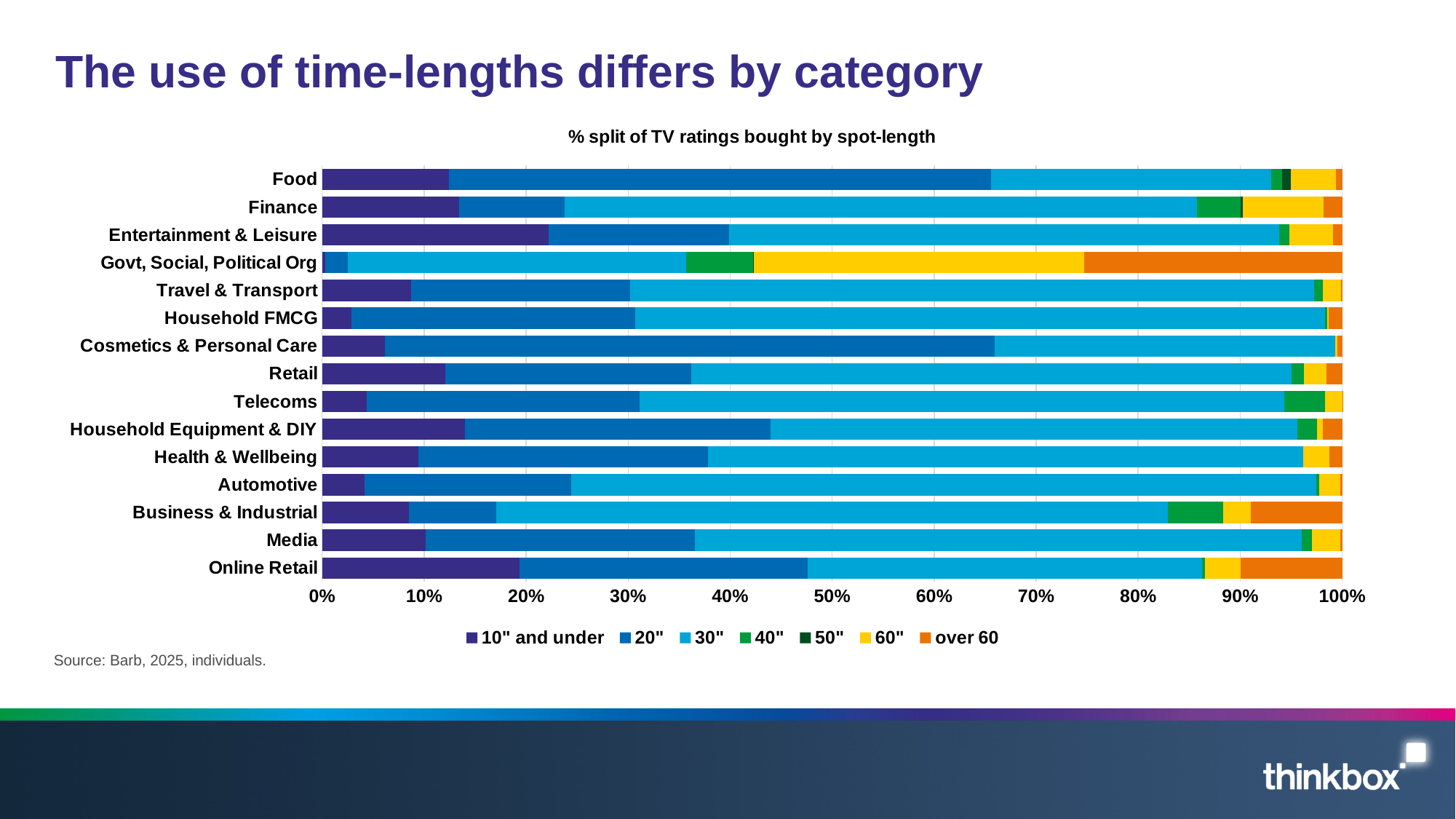
Is the 'over 60' share for Govt, Social, Political Org greater or less than 20%? greater Which has the larger '10" and under' share, Food or Govt, Social, Political Org? Food Is the '10" and under' share for Entertainment & Leisure greater or less than 20%? greater Is the '20"' share for Food greater or less than 50%? greater What is the title of the chart? % split of TV ratings bought by spot-length Which category has the largest '60"' share? Govt, Social, Political Org How many categories are plotted on the chart? 15 Which has the larger '20"' share, Cosmetics & Personal Care or Travel & Transport? Cosmetics & Personal Care How many series does the legend list? 7 Which category has the largest 'over 60' share? Govt, Social, Political Org What kind of chart is shown on the slide? bar chart